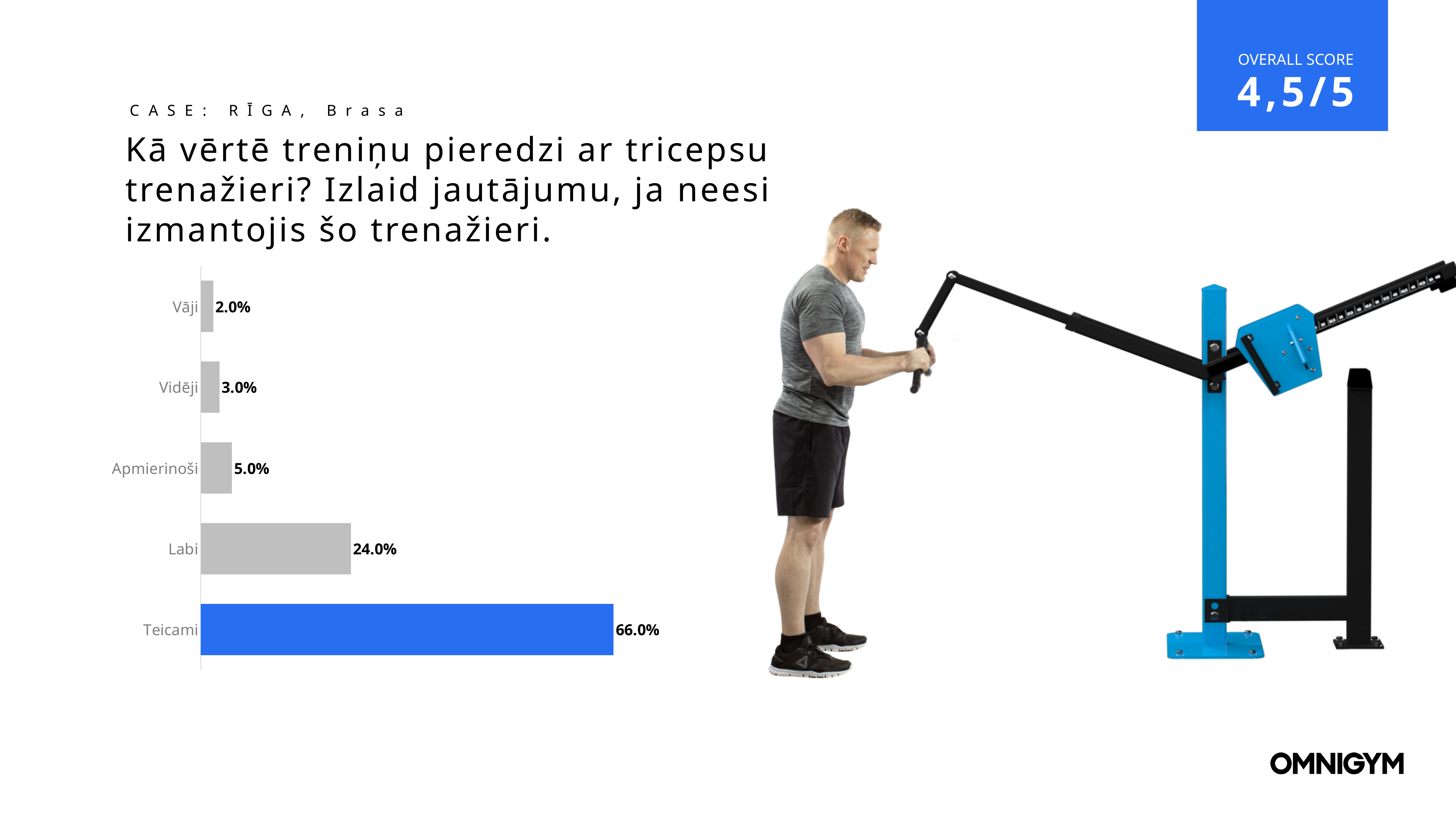
What is the value for Apmierinoši? 5.0% What is the difference between the values for Teicami and Labi? 42.0% What is the value for Teicami? 66.0% Which bar in the chart is coloured blue rather than grey? Teicami Which is larger, the value for Vidēji or the value for Apmierinoši? Apmierinoši What is the value for Vāji? 2.0% How many categories are shown in the chart? 5 Which category has the lowest value? Vāji Which category has the highest value? Teicami What is the total of the values for Vāji, Vidēji and Apmierinoši? 10.0% What kind of chart is shown on the slide? Bar chart What is the value for Labi? 24.0%